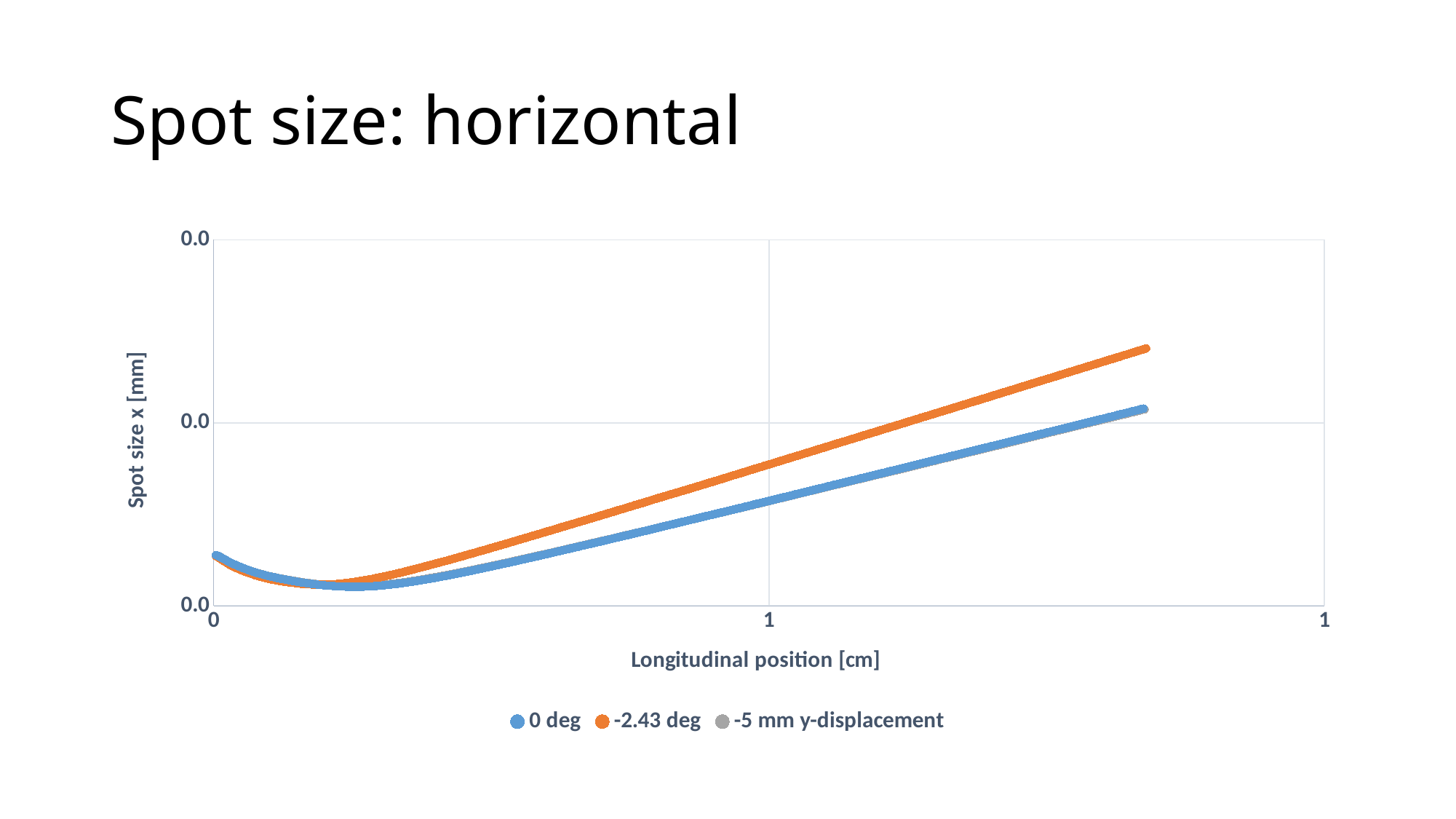
How many series does the legend list? 3 Over the right-hand half of the x axis, does the -2.43 deg series rise or fall as longitudinal position increases? Rise At the right end of the plotted data, which series has the larger spot size: 0 deg or -2.43 deg? -2.43 deg Which series reaches the highest spot size on the chart? -2.43 deg Which colour is used for the 0 deg series? Blue What is the label of the y axis? Spot size x [mm] What kind of chart is shown on the slide? Line chart What is the title of the slide's chart? Spot size: horizontal Over the right-hand half of the x axis, does the 0 deg series rise or fall as longitudinal position increases? Rise